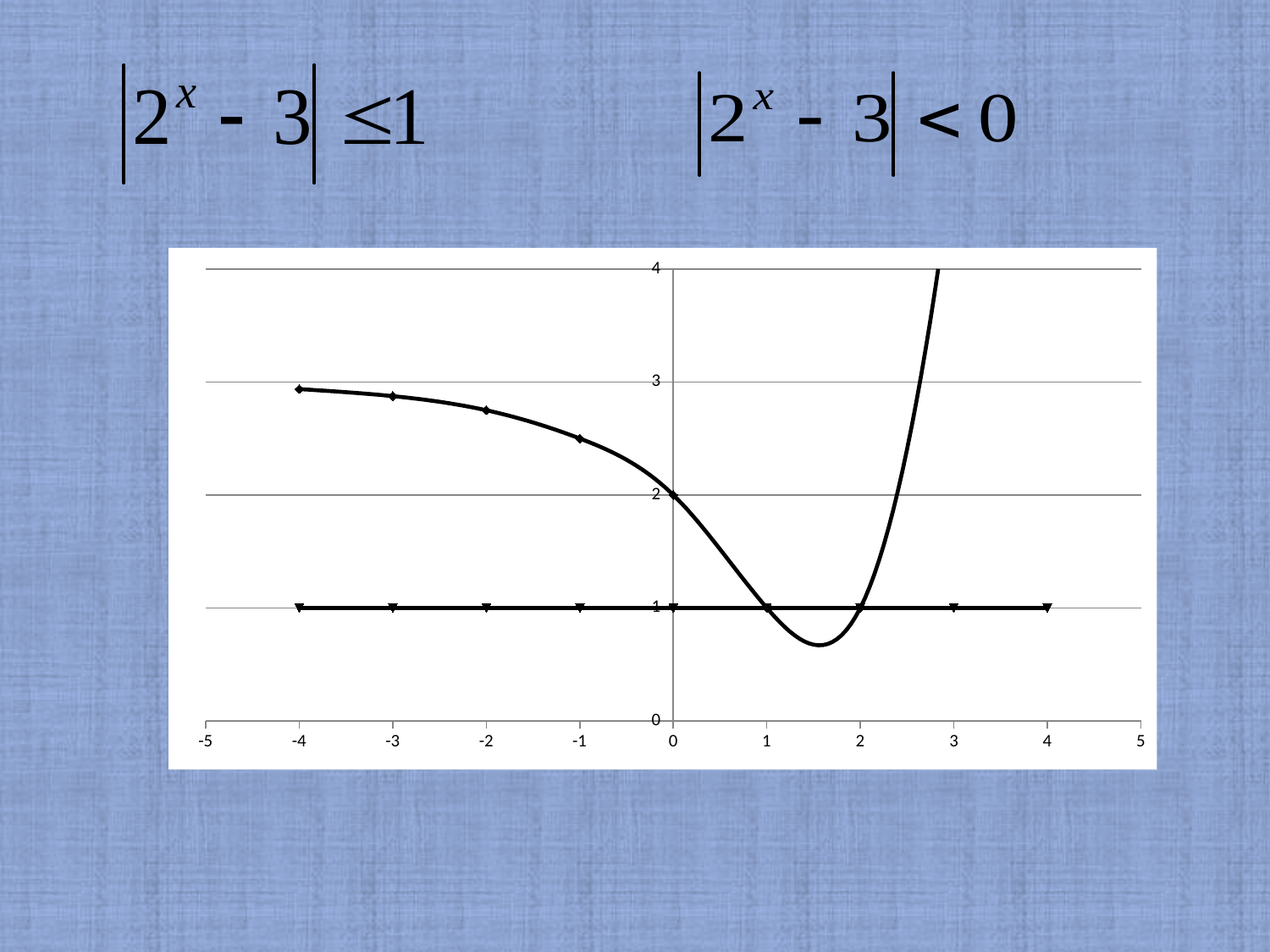
At x = -1, which is higher, the curve or the horizontal line? the curve Does the curve rise or fall as x goes from -4 to 0? fall What is the lowest value shown on the x axis? -5 What is the value of the horizontal line at x = -3? 1 What is the value of the curve at x = 1? 1 What is the value of the curve at x = 0? 2 Is the lowest point of the curve greater or less than 1? less How many marker points are shown on the horizontal line? 9 What kind of chart is shown on the slide? line chart What is the highest value shown on the y axis? 4 Is the value of the curve at x = -4 greater or less than 2? greater How many lines are plotted on the chart? 2